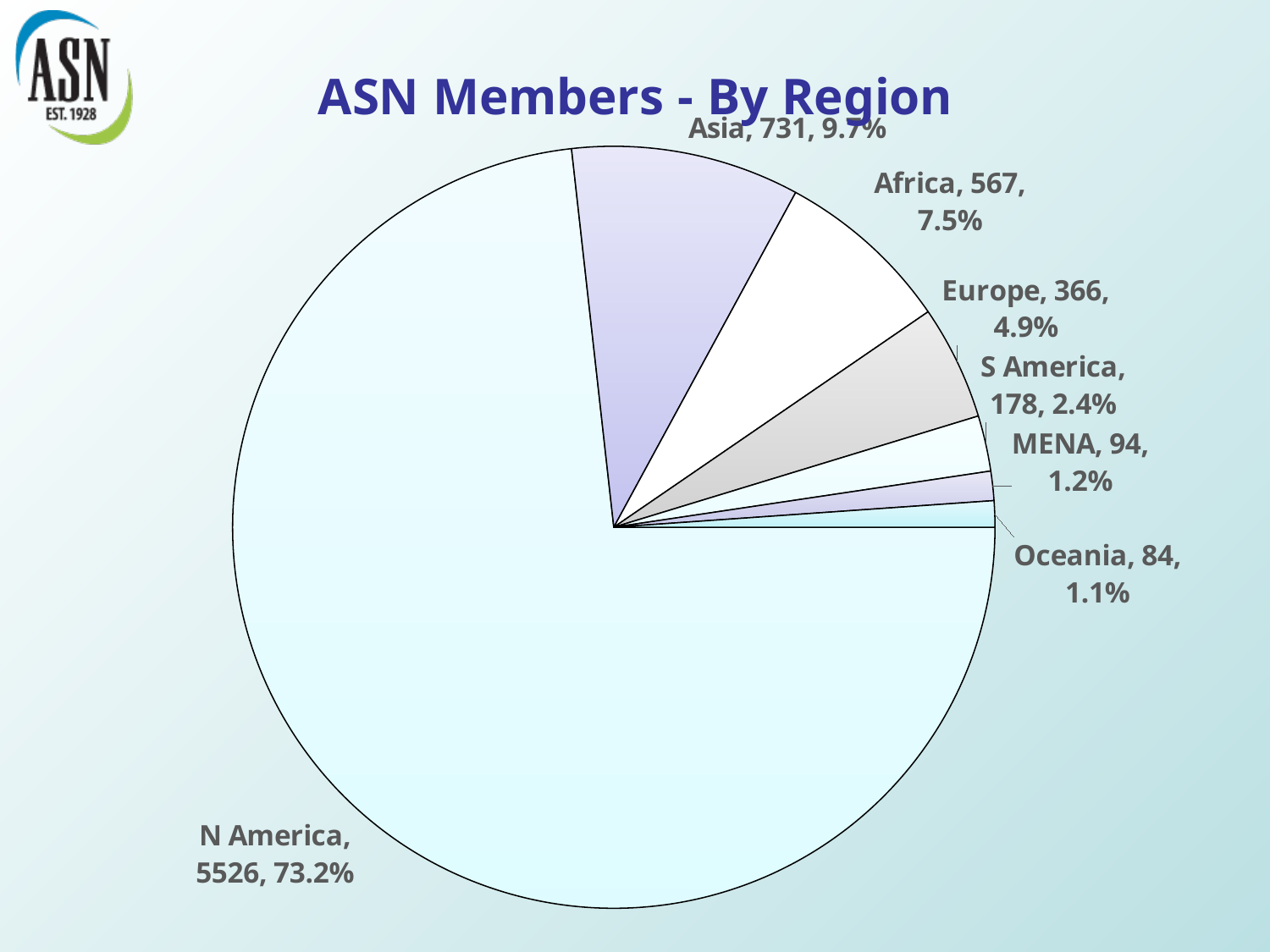
What kind of chart is shown on the slide? pie chart How many regions are shown in the pie chart? 7 Which region has the largest share of members? N America What percentage share of members is N America? 73.2% What is the difference in members between Asia and Africa? 164 What is the title of the chart? ASN Members - By Region How many members does the chart show for Asia? 731 Which region has the smallest share of members? Oceania How many members does the chart show for MENA? 94 Which region has more members, S America or MENA? S America How many members does the chart show for Europe? 366 What percentage share of members is Africa? 7.5%